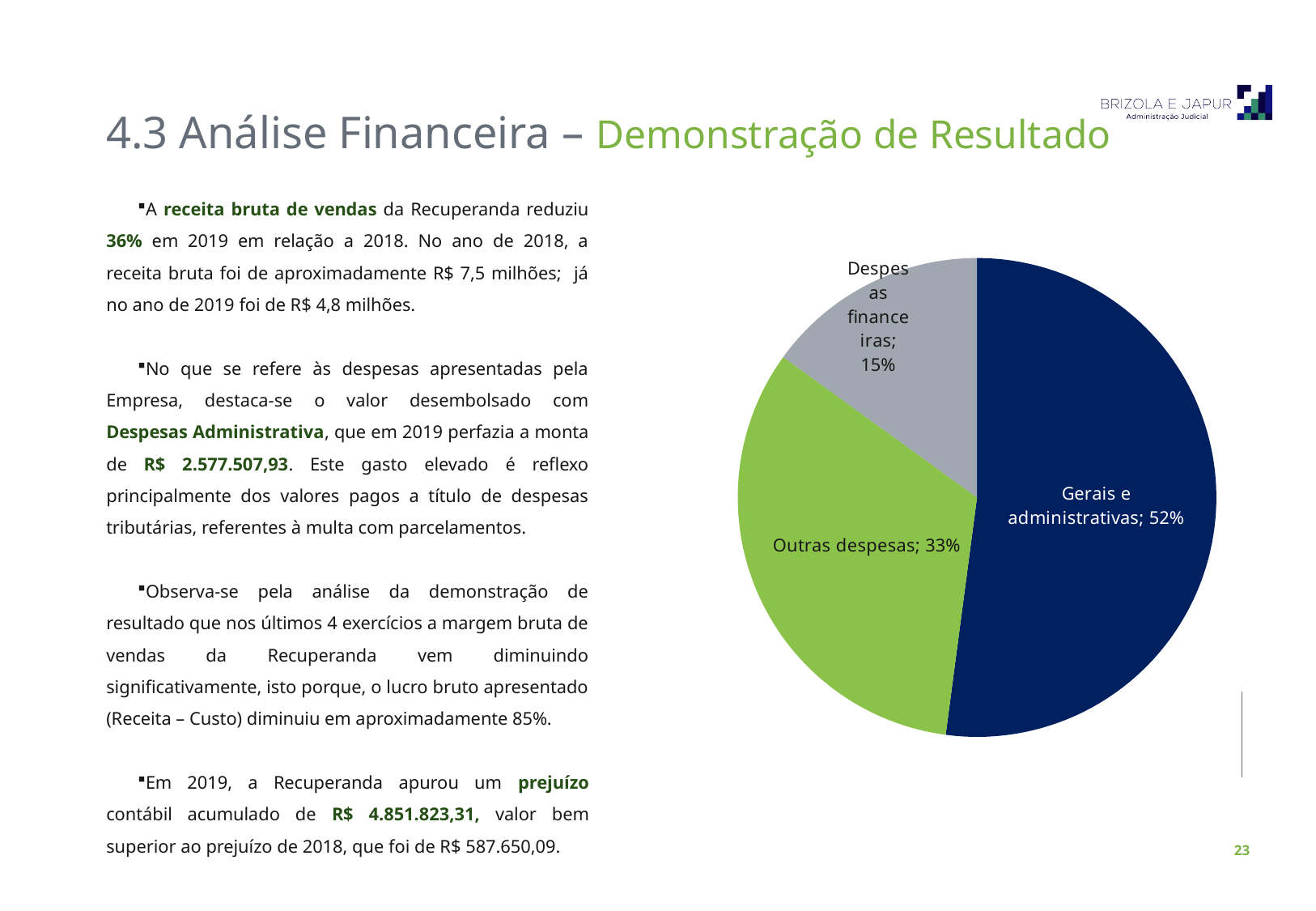
What share of the pie does "Gerais e administrativas" represent? 52% What share of the pie does "Despesas financeiras" represent? 15% What colour is the "Outras despesas" slice in the pie chart? green Which is larger in the pie chart, "Outras despesas" or "Despesas financeiras"? Outras despesas What kind of chart is shown on the slide? pie chart What is the difference in percentage points between "Gerais e administrativas" and "Outras despesas"? 19 Which slice of the pie chart is the smallest? Despesas financeiras Which slice of the pie chart is the largest? Gerais e administrativas What is the difference in percentage points between "Outras despesas" and "Despesas financeiras"? 18 What share of the pie does "Outras despesas" represent? 33% What colour is the "Gerais e administrativas" slice in the pie chart? dark blue How many slices does the pie chart have? 3